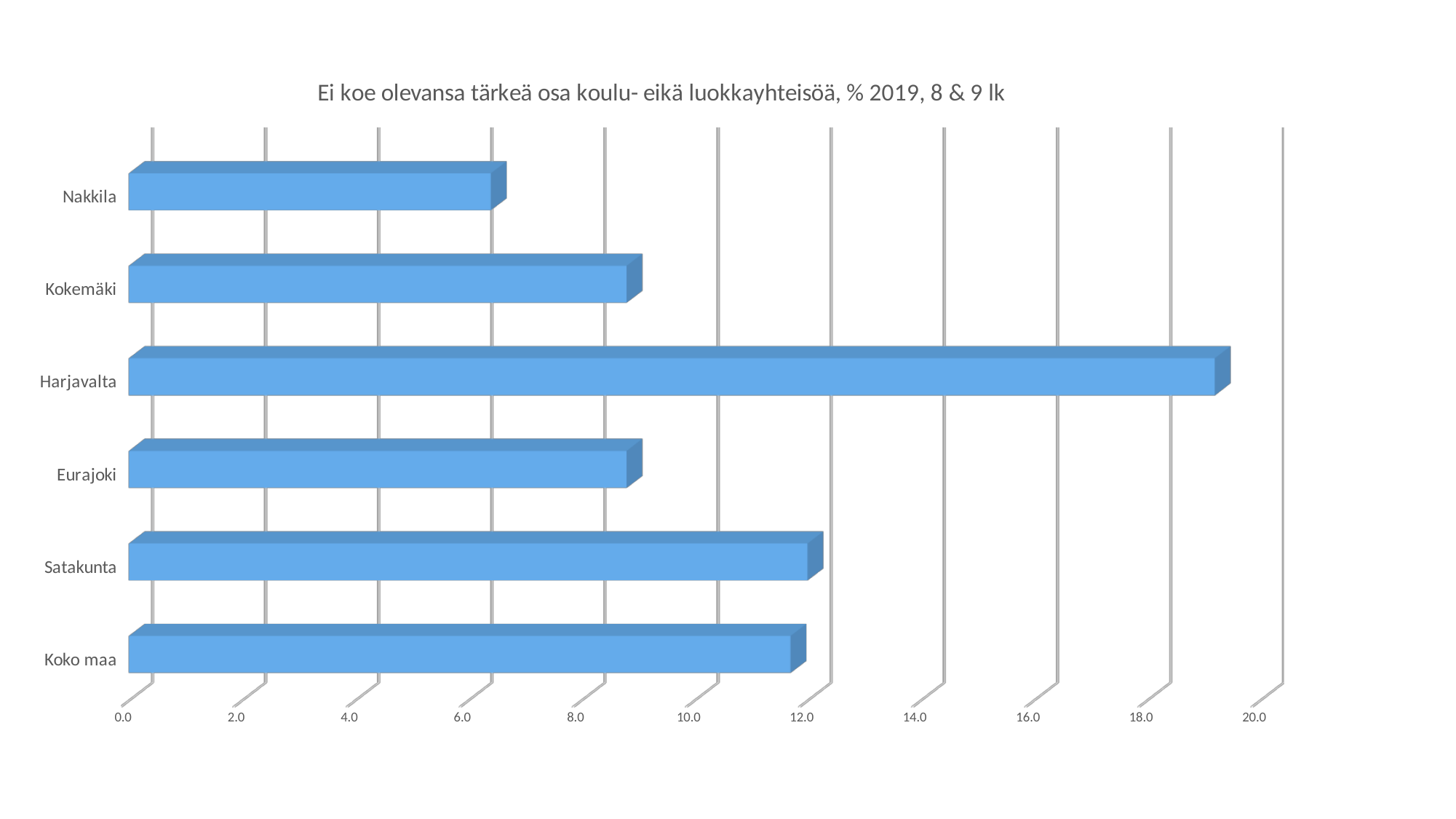
Is the value for Harjavalta greater or less than 18.0? greater What kind of chart is shown on the slide? bar chart Which is larger, the value for Harjavalta or the value for Satakunta? Harjavalta Is the value for Nakkila greater or less than 8.0? less Is the value for Satakunta greater or less than 10.0? greater What is the title of the chart? Ei koe olevansa tärkeä osa koulu- eikä luokkayhteisöä, % 2019, 8 & 9 lk Which category has the lowest value? Nakkila Which category has the highest value? Harjavalta Which is larger, the value for Koko maa or the value for Nakkila? Koko maa How many categories are plotted in the chart? 6